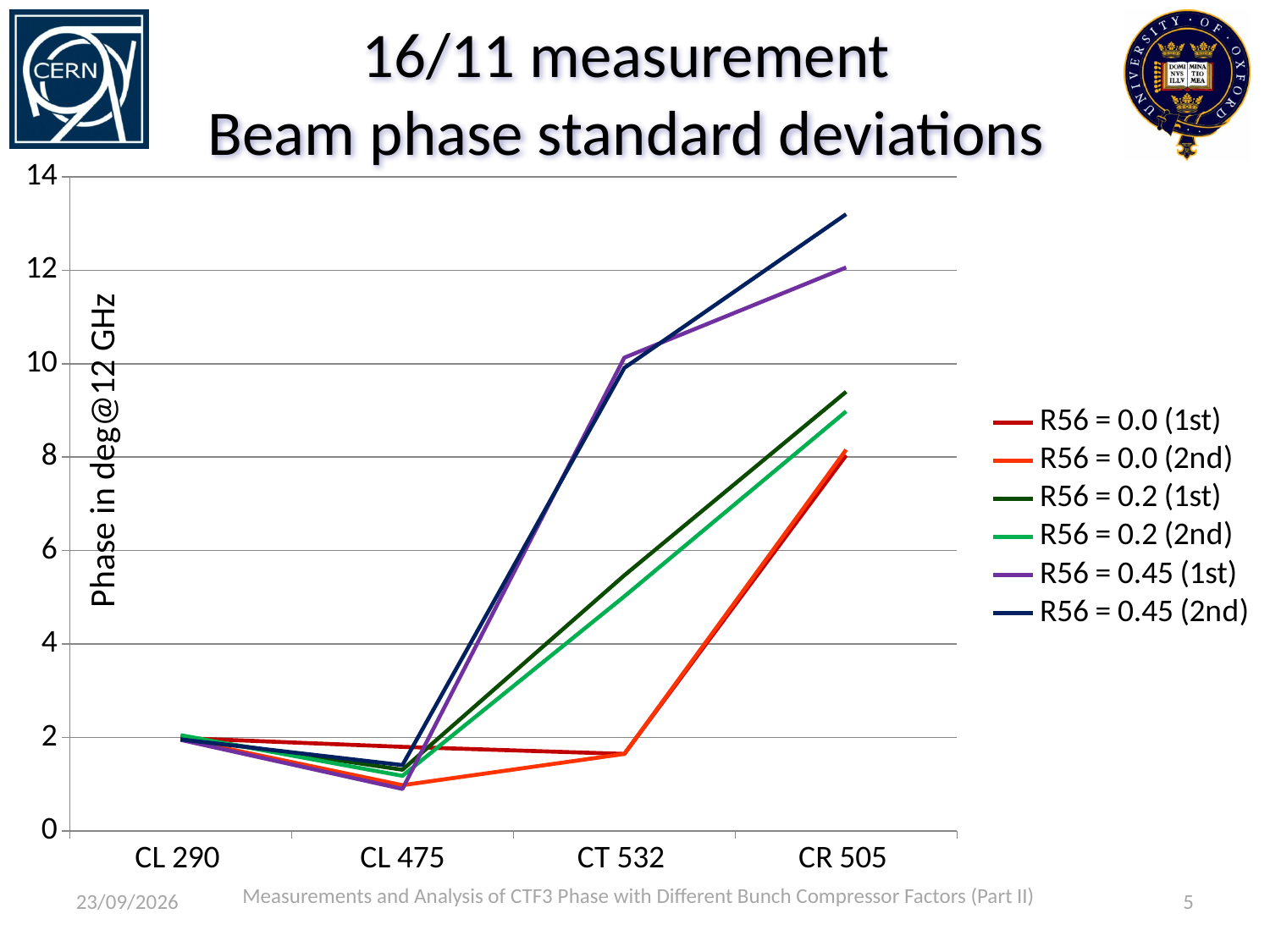
Does the value for R56 = 0.45 (2nd) rise or fall from CL 475 to CR 505? rise What is the label of the y axis? Phase in deg@12 GHz How many categories are shown on the x axis? 4 Is the value for R56 = 0.45 (2nd) at CR 505 greater or less than 12? greater Is the value for R56 = 0.0 (1st) at CT 532 greater or less than 2? less What kind of chart is shown on the slide? line chart At CT 532, which is larger: the value for R56 = 0.2 (1st) or the value for R56 = 0.0 (2nd)? R56 = 0.2 (1st) Is the value for R56 = 0.2 (1st) at CR 505 greater or less than 8? greater Which series has the highest value at CR 505? R56 = 0.45 (2nd) For the series R56 = 0.45 (1st), at which category is the value lowest? CL 475 How many series does the legend list? 6